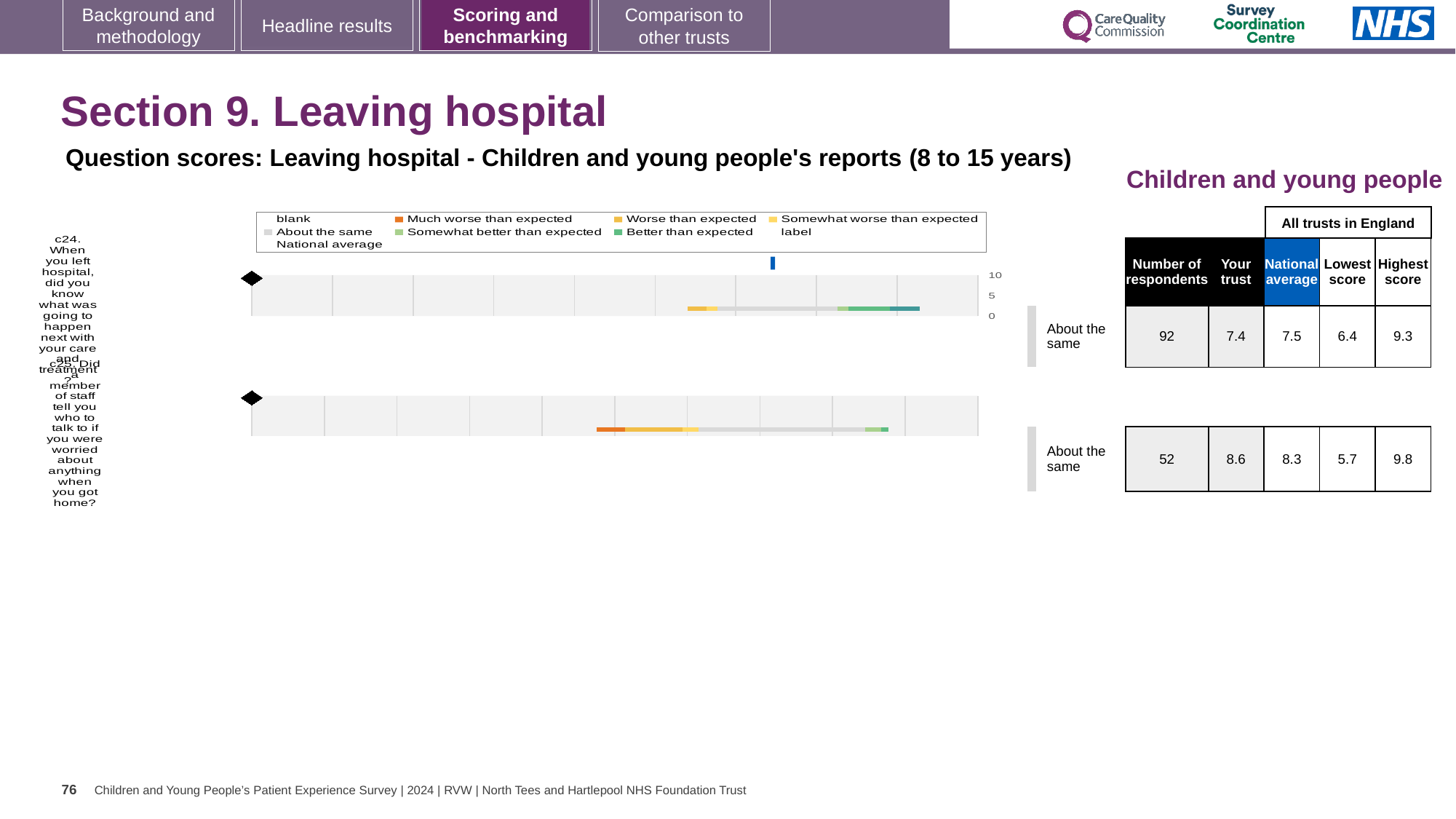
How many questions are plotted on the slide's charts? 2 What is the national average score for question c25 (Did a member of staff tell you who to talk to if you were worried about anything when you got home?)? 8.3 How many more respondents answered question c24 than question c25? 40 What is the difference between the 'Your trust' score and the national average for question c25? 0.3 For question c25, is the 'Your trust' score higher or lower than the national average? higher What is the 'Your trust' score for question c24 (When you left hospital, did you know what was going to happen next with your care and treatment?)? 7.4 How many respondents answered question c24? 92 What is the lowest score among all trusts in England for question c24? 6.4 Which question, c24 or c25, has the higher 'Your trust' score? c25 Is the 'Your trust' score for question c24 greater or less than 5 on the chart axis? greater What benchmark category is shown for both question c24 and question c25? About the same What is the highest score among all trusts in England for question c25? 9.8